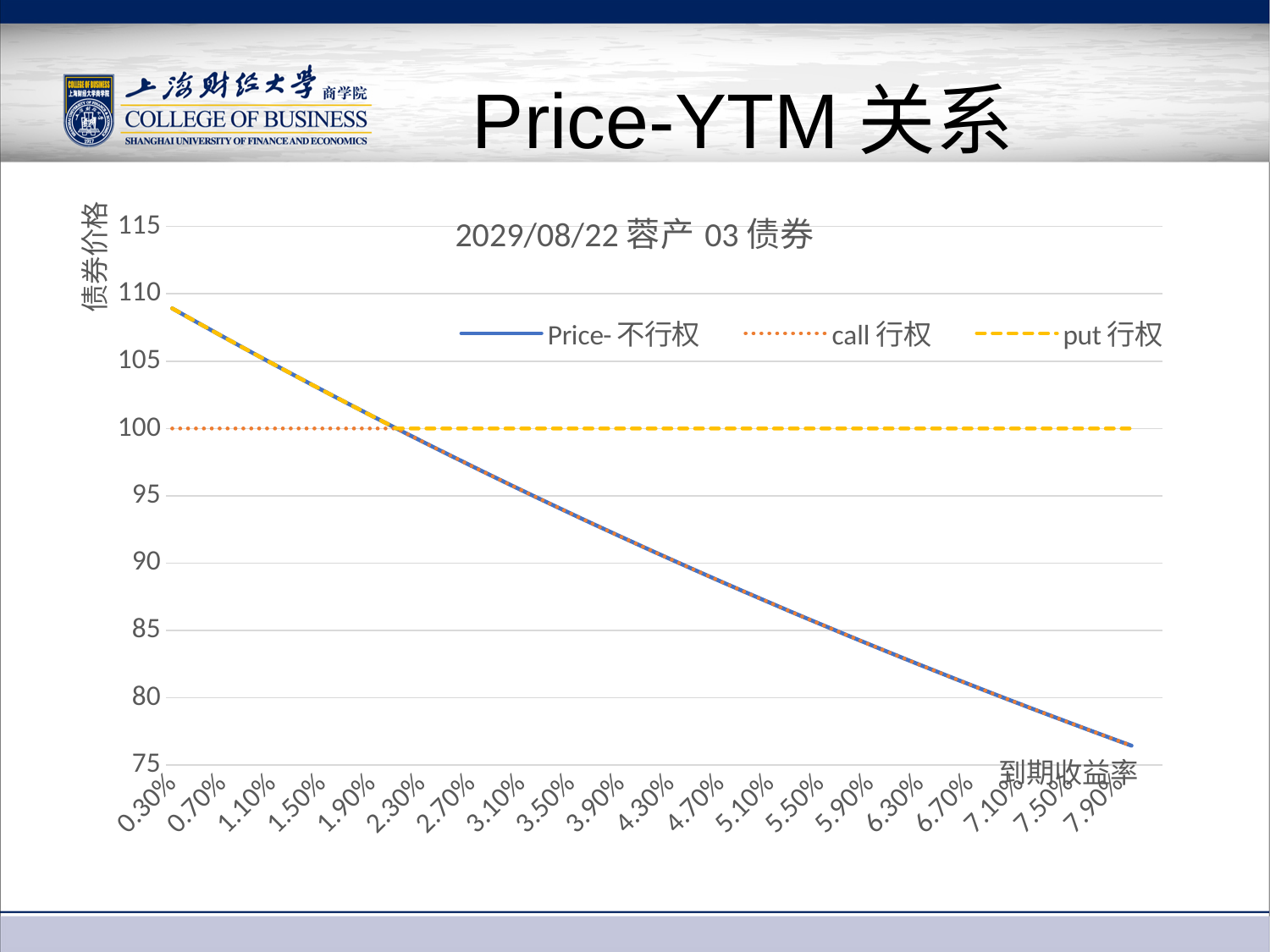
Is the value of Price-不行权 at 0.30% greater or less than 105? greater Is the value of call 行权 at 0.30% greater or less than 105? less Is the value of put 行权 at 7.90% greater or less than 95? greater Does the Price-不行权 series rise or fall as the yield increases along the x axis? fall What is the label of the vertical axis? 债券价格 What kind of chart is shown on the slide? line chart What is the title of the chart? 2029/08/22 蓉产 03 债券 How many series does the legend list? 3 At 0.30%, which series has the higher value: Price-不行权 or call 行权? Price-不行权 How many yield labels are shown on the x axis? 20